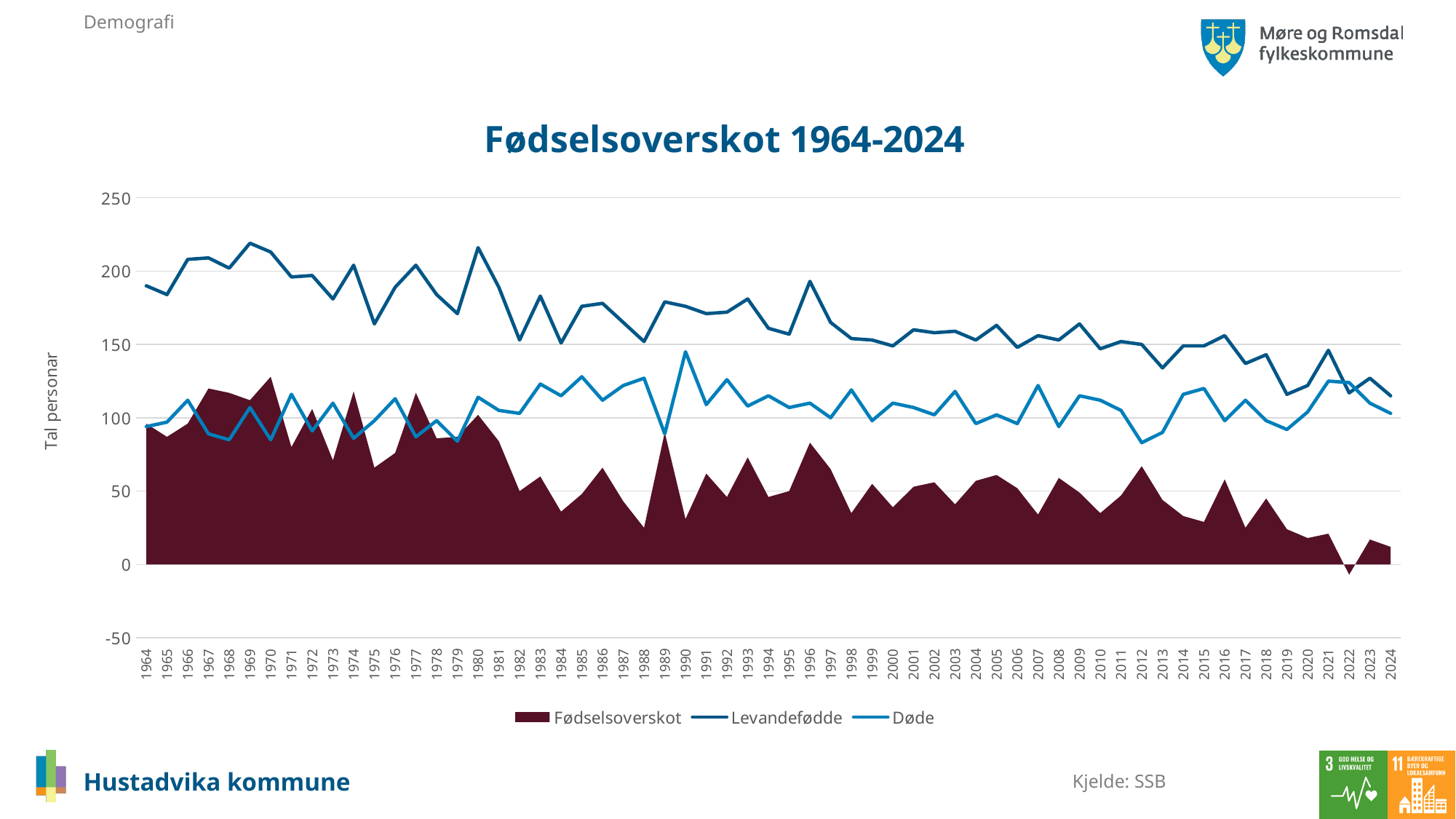
What is the label on the vertical axis of the chart? Tal personar Is the value for Fødselsoverskot in 1970 greater or less than 100? greater Does the Levandefødde series generally rise or fall from 1964 to 2024? fall What is the title of the chart? Fødselsoverskot 1964-2024 In which year does the Døde series reach its highest value? 1990 Is the value for Levandefødde in 1969 greater or less than 200? greater What kind of chart is used to plot the Levandefødde and Døde series? line chart Is the value for Levandefødde in 2024 greater or less than 150? less How many years are plotted along the x axis of the chart? 61 How many series does the chart legend list? 3 In which year is the Fødselsoverskot value lowest? 2022